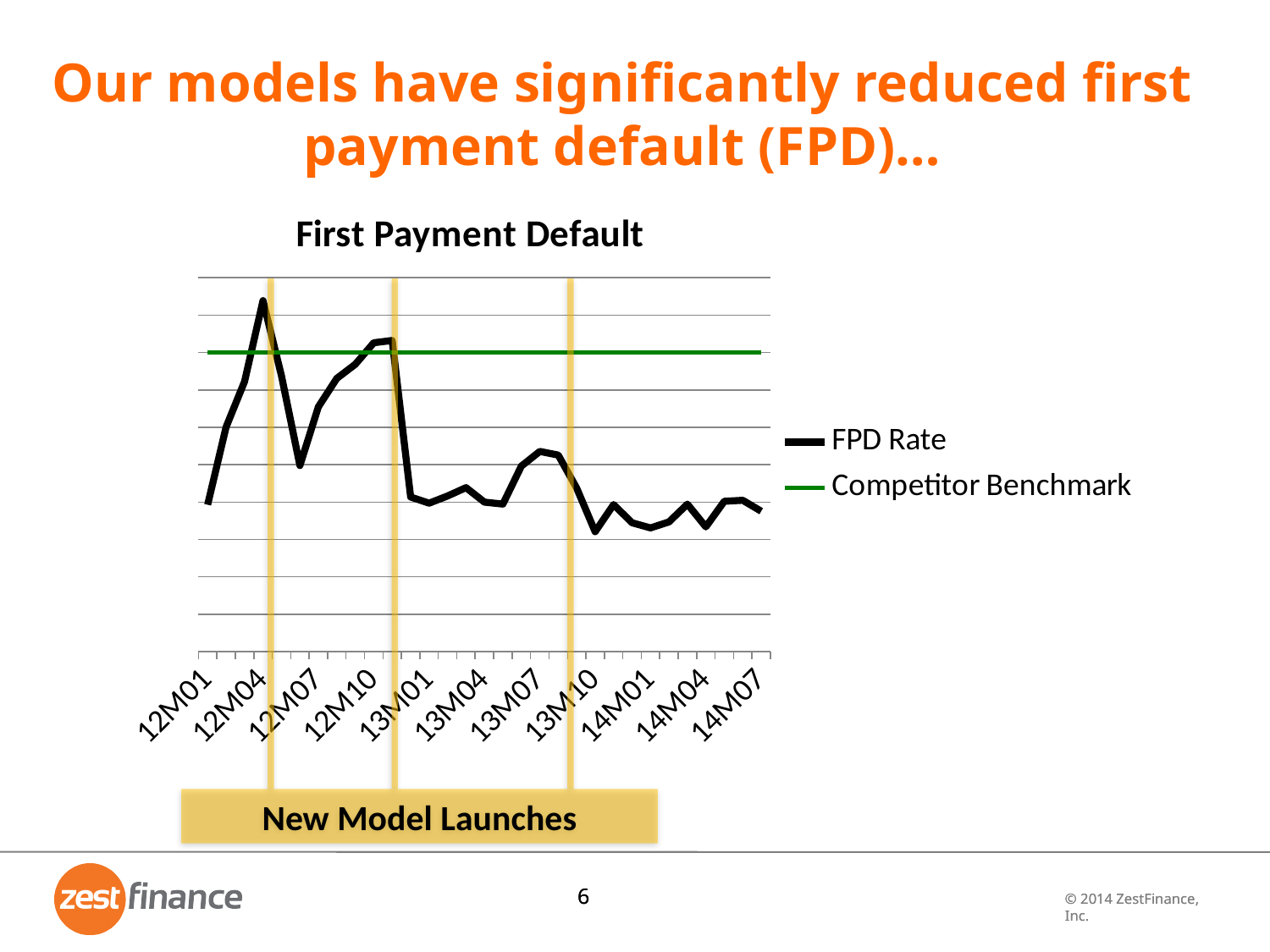
What is the title of the chart? First Payment Default At 12M01, is the FPD Rate above or below the Competitor Benchmark? below At 14M07, is the FPD Rate above or below the Competitor Benchmark? below At 13M04, is the FPD Rate above or below the Competitor Benchmark? below Which series is drawn as a green line? Competitor Benchmark What kind of chart is shown on the slide? line chart How many vertical yellow bars marking New Model Launches are drawn on the chart? 3 Does the FPD Rate rise or fall between 12M07 and 12M10? rise How many series does the legend list? 2 How many month labels are shown along the x axis? 11